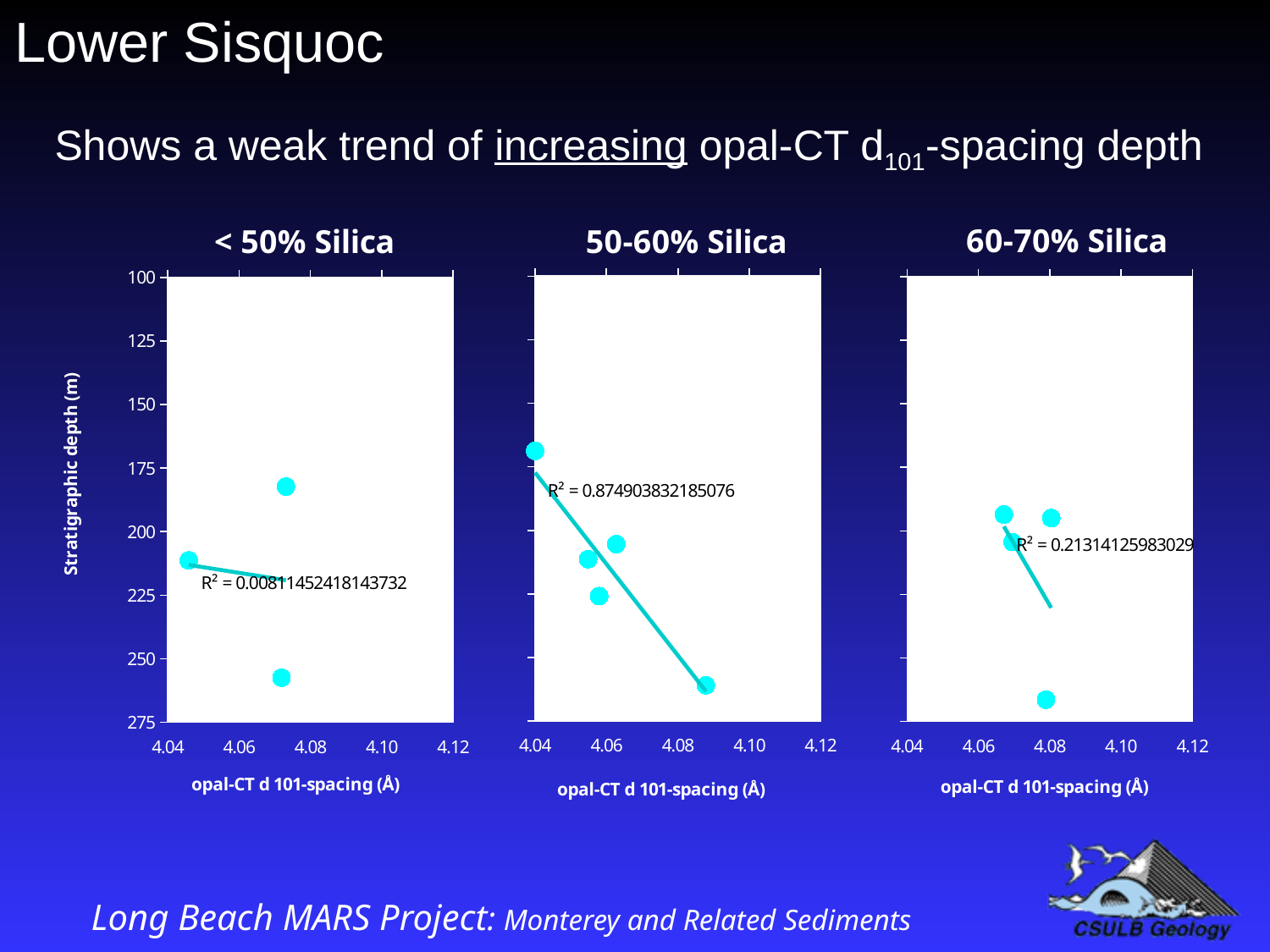
What is the x-axis label on the '50-60% Silica' chart? opal-CT d 101-spacing (Å) How many data points are plotted on the '< 50% Silica' chart? 3 Which of the three charts shows the lowest R² value? < 50% Silica On the '< 50% Silica' chart, is the stratigraphic depth of the deepest point greater or less than 250 m? greater What R² value is printed on the '< 50% Silica' chart? R² = 0.00811452418143732 On the '50-60% Silica' chart, is the stratigraphic depth of the point at 4.04 Å greater or less than 175 m? less What R² value is printed on the '60-70% Silica' chart? R² = 0.21314125983029 Is the R² value on the '60-70% Silica' chart larger or smaller than the R² value on the '< 50% Silica' chart? larger How many data points are plotted on the '50-60% Silica' chart? 5 What kind of chart is the '< 50% Silica' chart? scatter chart What R² value is printed on the '50-60% Silica' chart? R² = 0.874903832185076 Which of the three charts shows the highest R² value? 50-60% Silica